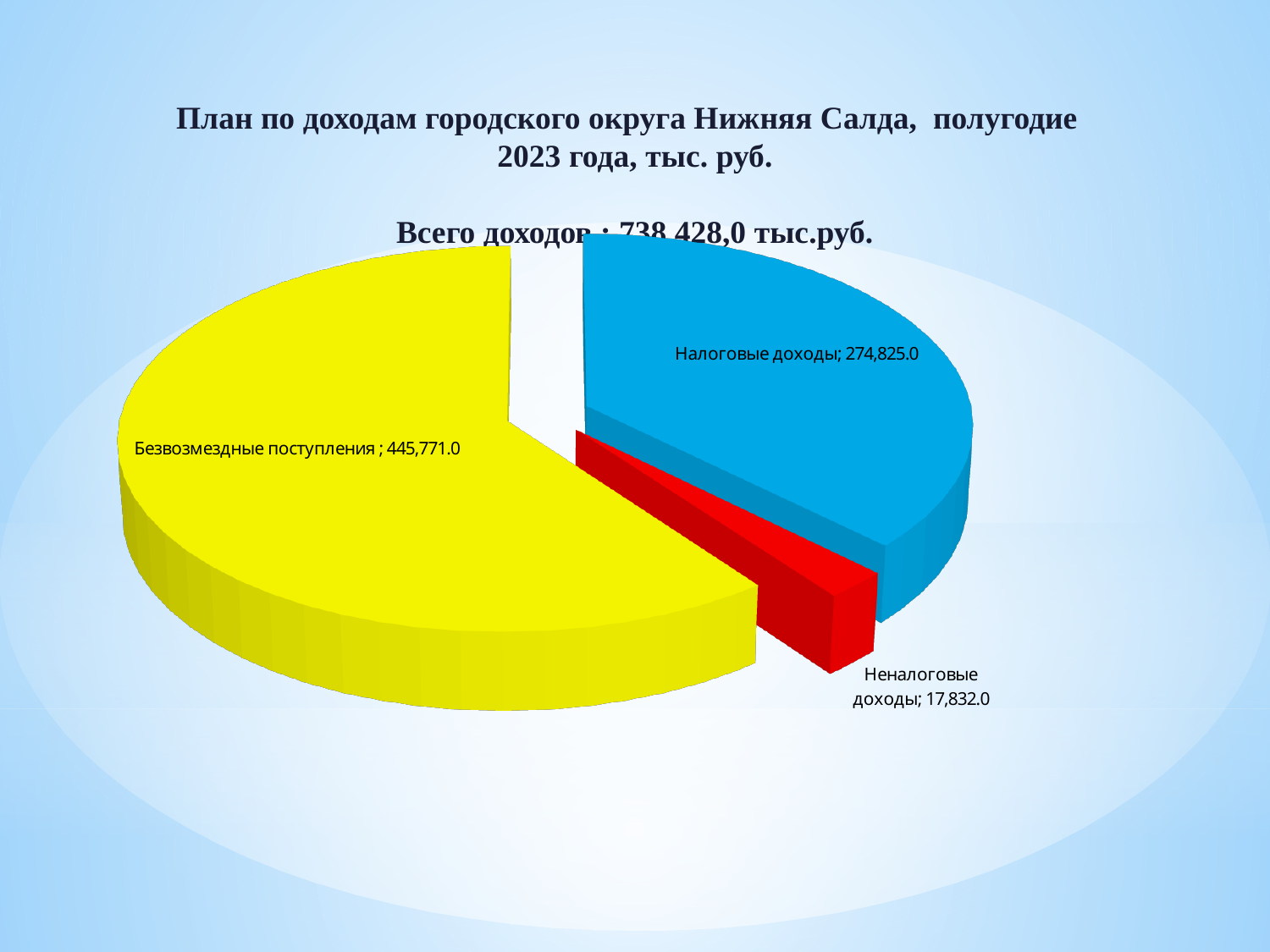
What is the value for Налоговые доходы? 274,825.0 How many categories are shown in the pie chart? 3 What is the total of all incomes stated on the slide? 738 428,0 тыс.руб. Which category has the largest slice of the pie? Безвозмездные поступления What is the value for Неналоговые доходы? 17,832.0 What is the difference between Налоговые доходы and Неналоговые доходы? 256,993.0 What type of chart is shown on the slide? Pie chart Which is larger, Налоговые доходы or Неналоговые доходы? Налоговые доходы What is the difference between Безвозмездные поступления and Налоговые доходы? 170,946.0 Which category has the smallest slice of the pie? Неналоговые доходы What is the value for Безвозмездные поступления? 445,771.0 What colour is the slice for Неналоговые доходы? Red